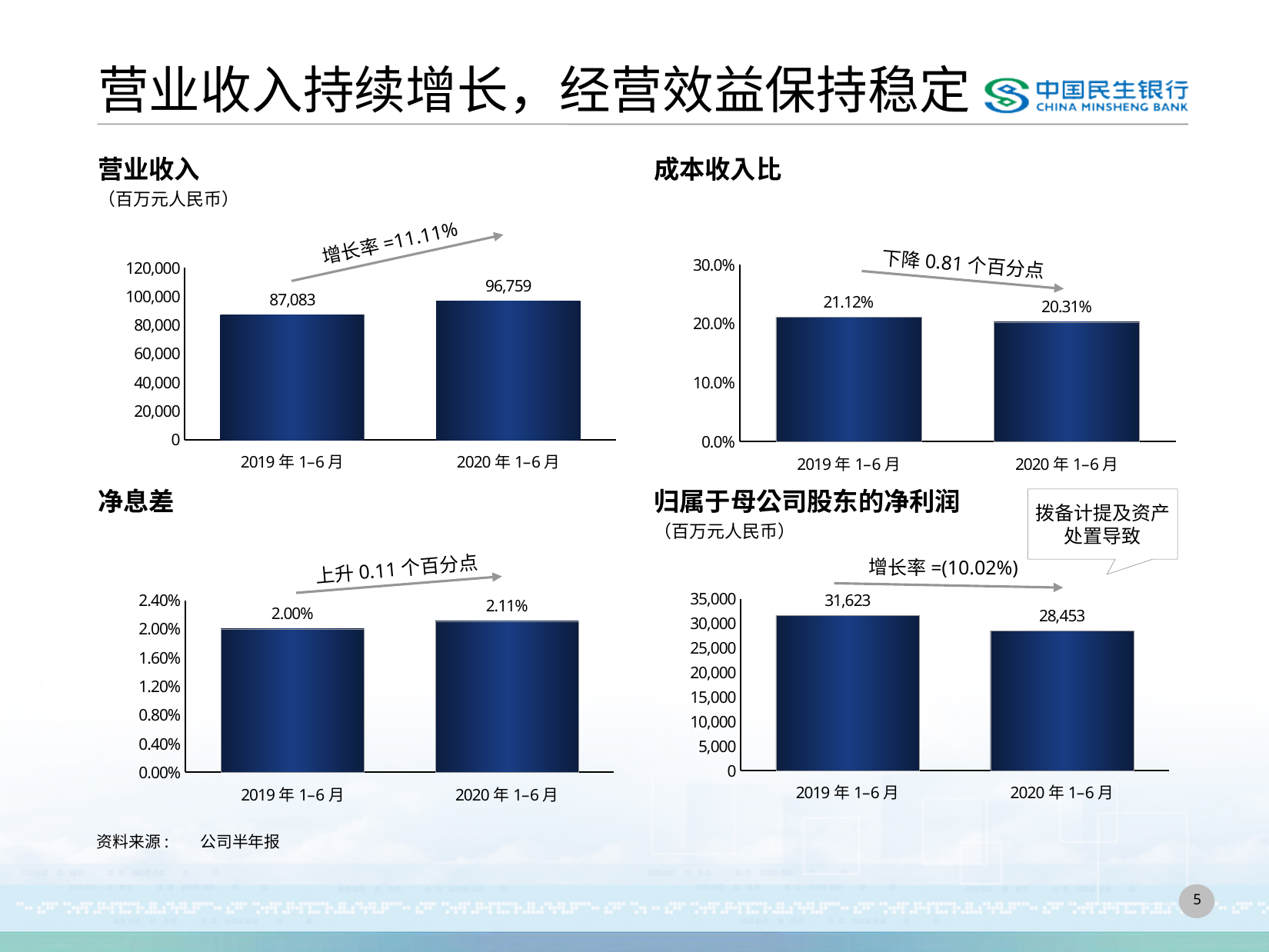
In the 净息差 chart, what is the difference between the 2020年1-6月 and 2019年1-6月 values? 0.11% In the 营业收入 chart, what is the difference between the 2020年1-6月 and 2019年1-6月 values? 9,676 In the 成本收入比 chart, what is the value for 2020年1-6月? 20.31% In the 营业收入 chart, what is the value for 2019年1-6月? 87,083 In the 成本收入比 chart, do the values rise or fall from 2019年1-6月 to 2020年1-6月? fall In the 营业收入 chart, what is the value for 2020年1-6月? 96,759 In the 归属于母公司股东的净利润 chart, which period has the lower value? 2020年1-6月 How many bars are plotted in the 营业收入 chart? 2 In the 成本收入比 chart, which period has the higher value? 2019年1-6月 What type of chart is the 净息差 chart? bar chart In the 归属于母公司股东的净利润 chart, what is the value for 2020年1-6月? 28,453 In the 净息差 chart, what is the value for 2019年1-6月? 2.00%